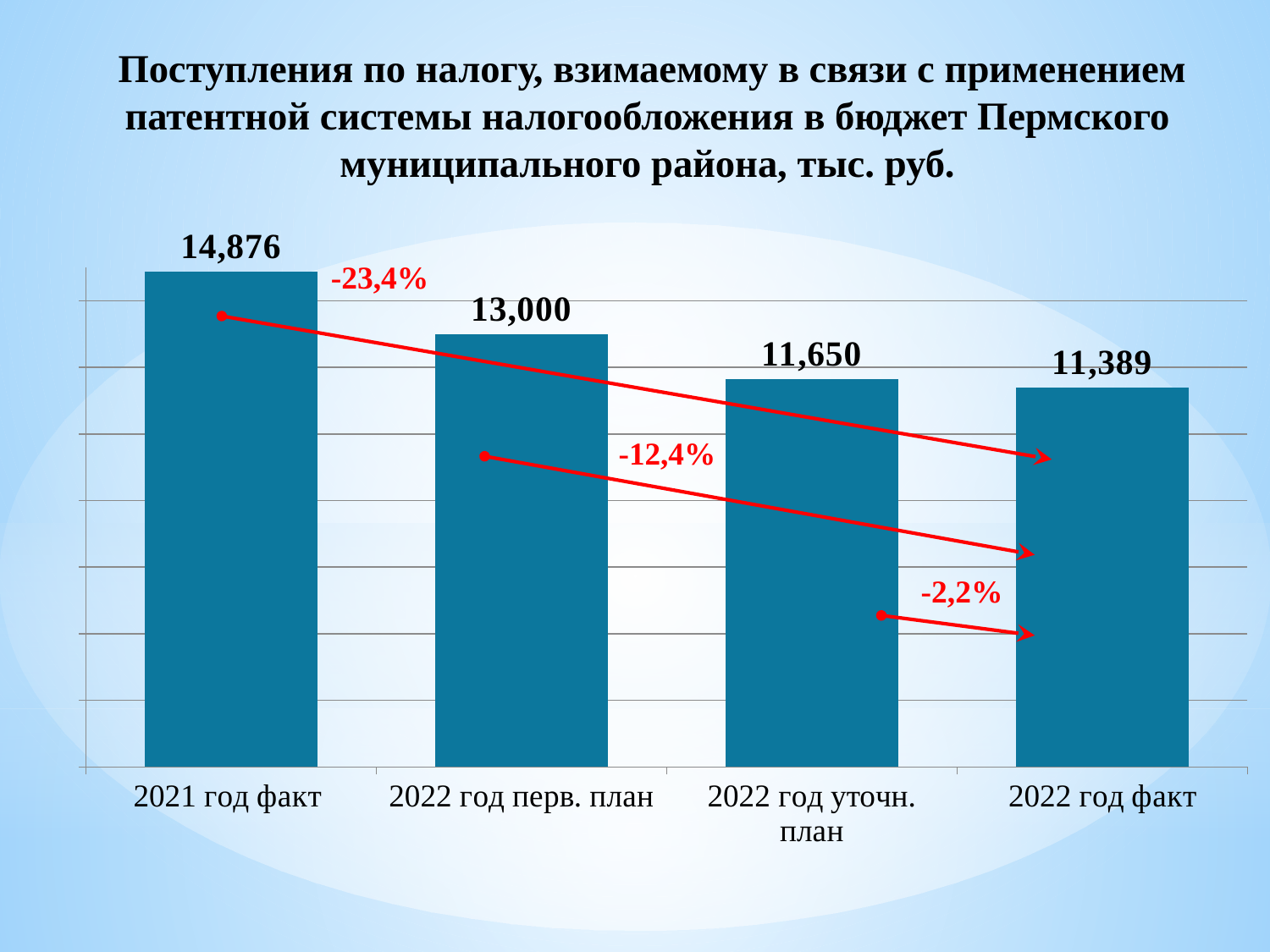
What is the difference between the values for 2021 год факт and 2022 год факт? 3,487 What is the value for 2022 год уточн. план? 11,650 What is the difference between the values for 2022 год перв. план and 2022 год уточн. план? 1,350 What is the value for 2021 год факт? 14,876 What is the value for 2022 год перв. план? 13,000 What percentage change is annotated between 2021 год факт and 2022 год факт? -23,4% What kind of chart is shown on the slide? Bar chart How many bars are shown in the chart? 4 Which is larger, the value for 2022 год перв. план or the value for 2022 год факт? 2022 год перв. план What is the value for 2022 год факт? 11,389 Which category has the highest value? 2021 год факт Which category has the lowest value? 2022 год факт